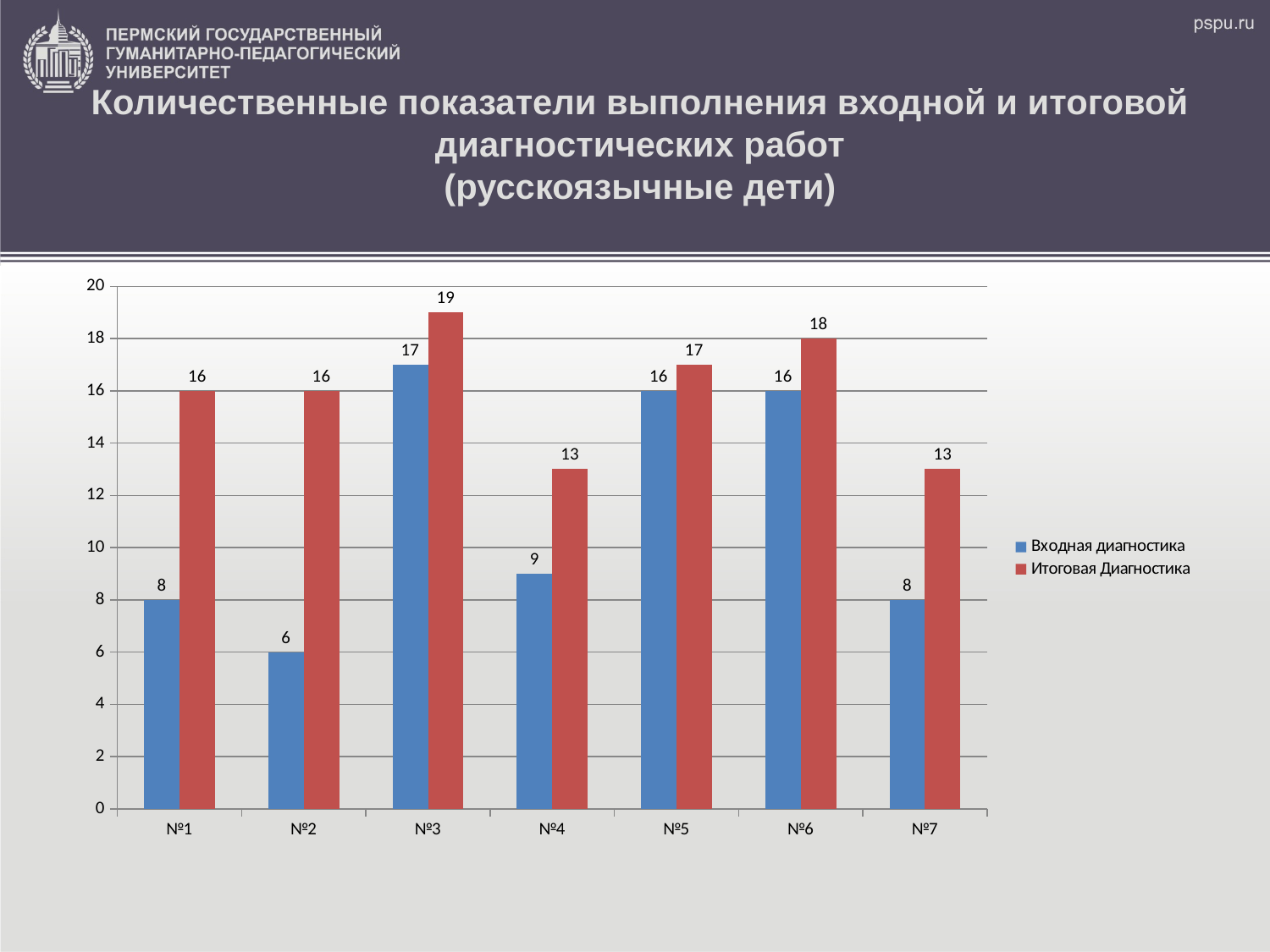
What kind of chart is shown on the slide? bar chart What is the difference between the Входная диагностика values for №3 and №7? 9 Which category has the lowest Входная диагностика value? №2 How many series does the legend list? 2 Which colour represents Итоговая Диагностика in the legend? red What is the difference between Итоговая Диагностика and Входная диагностика for №2? 10 How many categories are shown on the x axis? 7 Which is larger for №5: Входная диагностика or Итоговая Диагностика? Итоговая Диагностика Which category has the highest Итоговая Диагностика value? №3 What is the value of Входная диагностика for №3? 17 What is the value of Входная диагностика for №1? 8 What is the value of Итоговая Диагностика for №4? 13